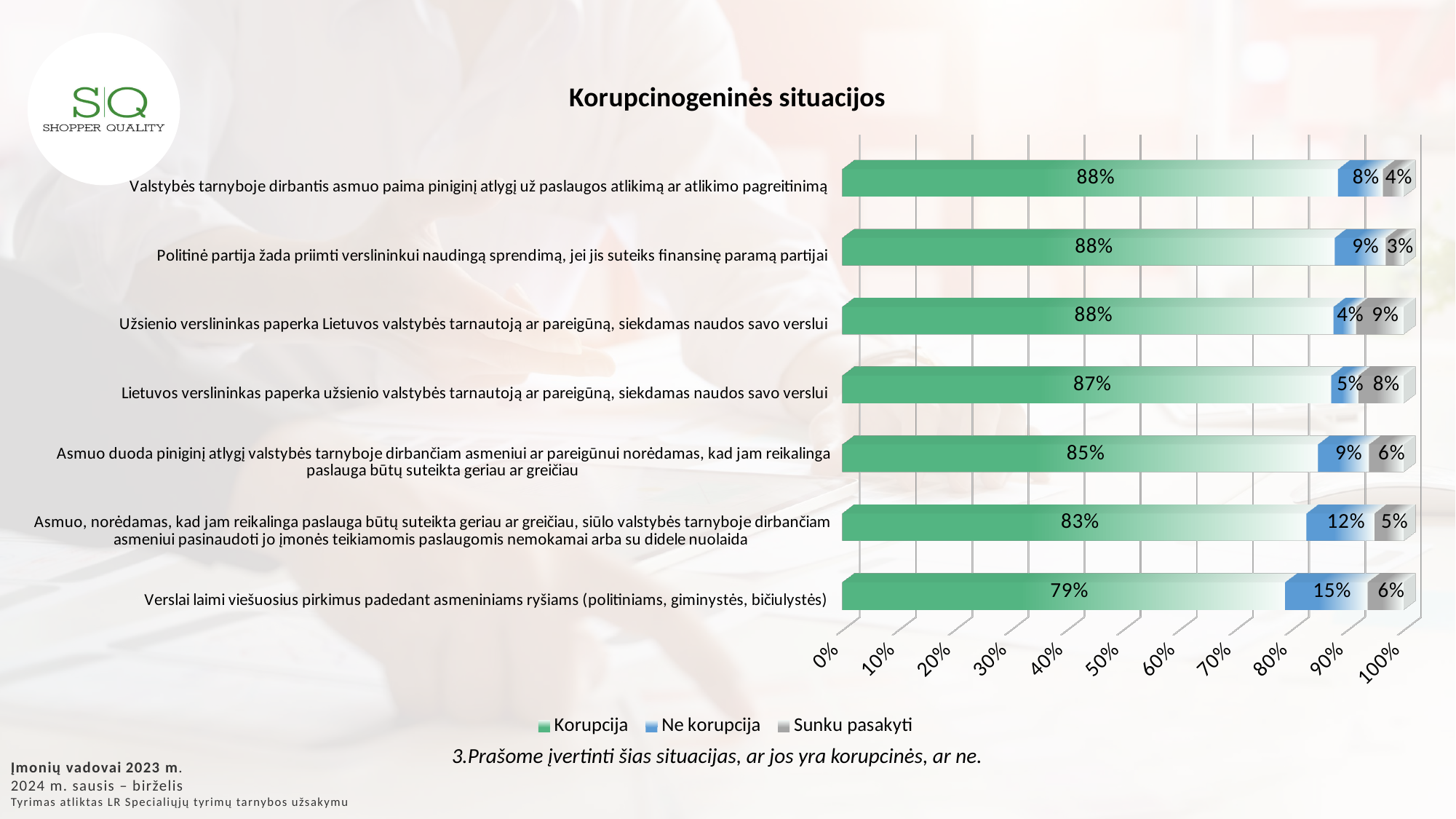
What is the difference between the Korupcija values for 'Politinė partija žada priimti verslininkui naudingą sprendimą, jei jis suteiks finansinę paramą partijai' and 'Verslai laimi viešuosius pirkimus padedant asmeniniams ryšiams (politiniams, giminystės, bičiulystės)'? 9% What is the total of the stacked bar for 'Valstybės tarnyboje dirbantis asmuo paima piniginį atlygį už paslaugos atlikimą ar atlikimo pagreitinimą'? 100% What is the Ne korupcija value for 'Asmuo, norėdamas, kad jam reikalinga paslauga būtų suteikta geriau ar greičiau, siūlo valstybės tarnyboje dirbančiam asmeniui pasinaudoti jo įmonės teikiamomis paslaugomis nemokamai arba su didele nuolaida'? 12% What type of chart is shown on the slide? Stacked bar chart Which situation has the highest Ne korupcija value? Verslai laimi viešuosius pirkimus padedant asmeniniams ryšiams (politiniams, giminystės, bičiulystės) Which is larger: the Ne korupcija value for 'Asmuo duoda piniginį atlygį valstybės tarnyboje dirbančiam asmeniui ar pareigūnui norėdamas, kad jam reikalinga paslauga būtų suteikta geriau ar greičiau' or for 'Lietuvos verslininkas paperka užsienio valstybės tarnautoją ar pareigūną, siekdamas naudos savo verslui'? Asmuo duoda piniginį atlygį valstybės tarnyboje dirbančiam asmeniui ar pareigūnui norėdamas, kad jam reikalinga paslauga būtų suteikta geriau ar greičiau What is the title of the chart? Korupcinogeninės situacijos How many series does the legend list? 3 Which situation has the lowest Korupcija value? Verslai laimi viešuosius pirkimus padedant asmeniniams ryšiams (politiniams, giminystės, bičiulystės) What is the Sunku pasakyti value for 'Užsienio verslininkas paperka Lietuvos valstybės tarnautoją ar pareigūną, siekdamas naudos savo verslui'? 9% How many situations (categories) are plotted in the chart? 7 What is the Korupcija value for 'Verslai laimi viešuosius pirkimus padedant asmeniniams ryšiams (politiniams, giminystės, bičiulystės)'? 79%